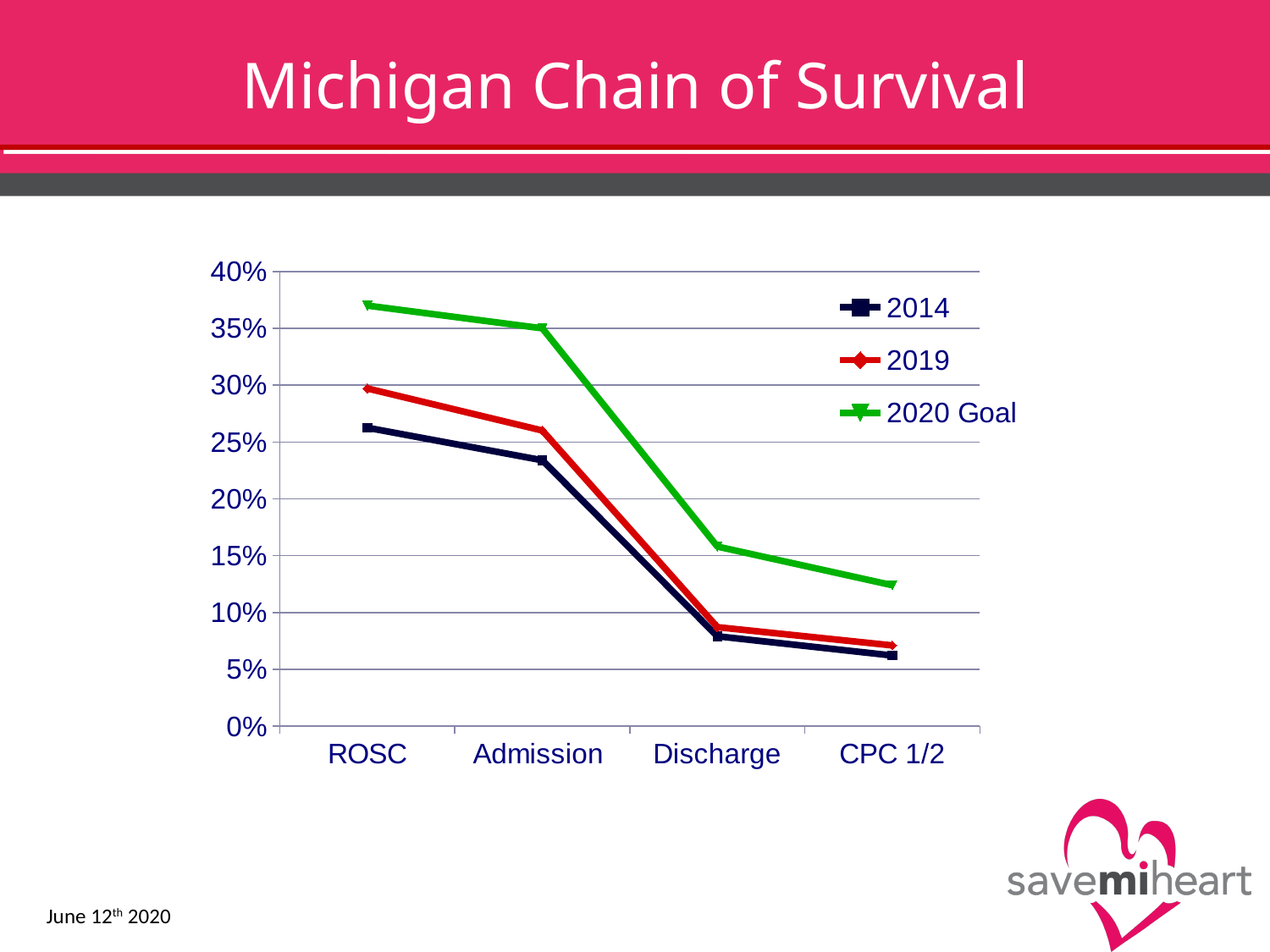
How many series does the chart's legend list? 3 Do the values for the 2019 series rise or fall from ROSC to CPC 1/2? fall Is the 2020 Goal value for ROSC greater or less than 35%? greater Is the 2014 value for Discharge greater or less than 10%? less Is the 2019 value for ROSC greater or less than 25%? greater At ROSC, which series has the larger value, 2014 or 2019? 2019 How many categories are shown on the x axis of the chart? 4 For the 2020 Goal series, which category has the highest value? ROSC For the 2019 series, which category has the lowest value? CPC 1/2 What is the title of the slide containing the chart? Michigan Chain of Survival What kind of chart is shown on the slide? line chart